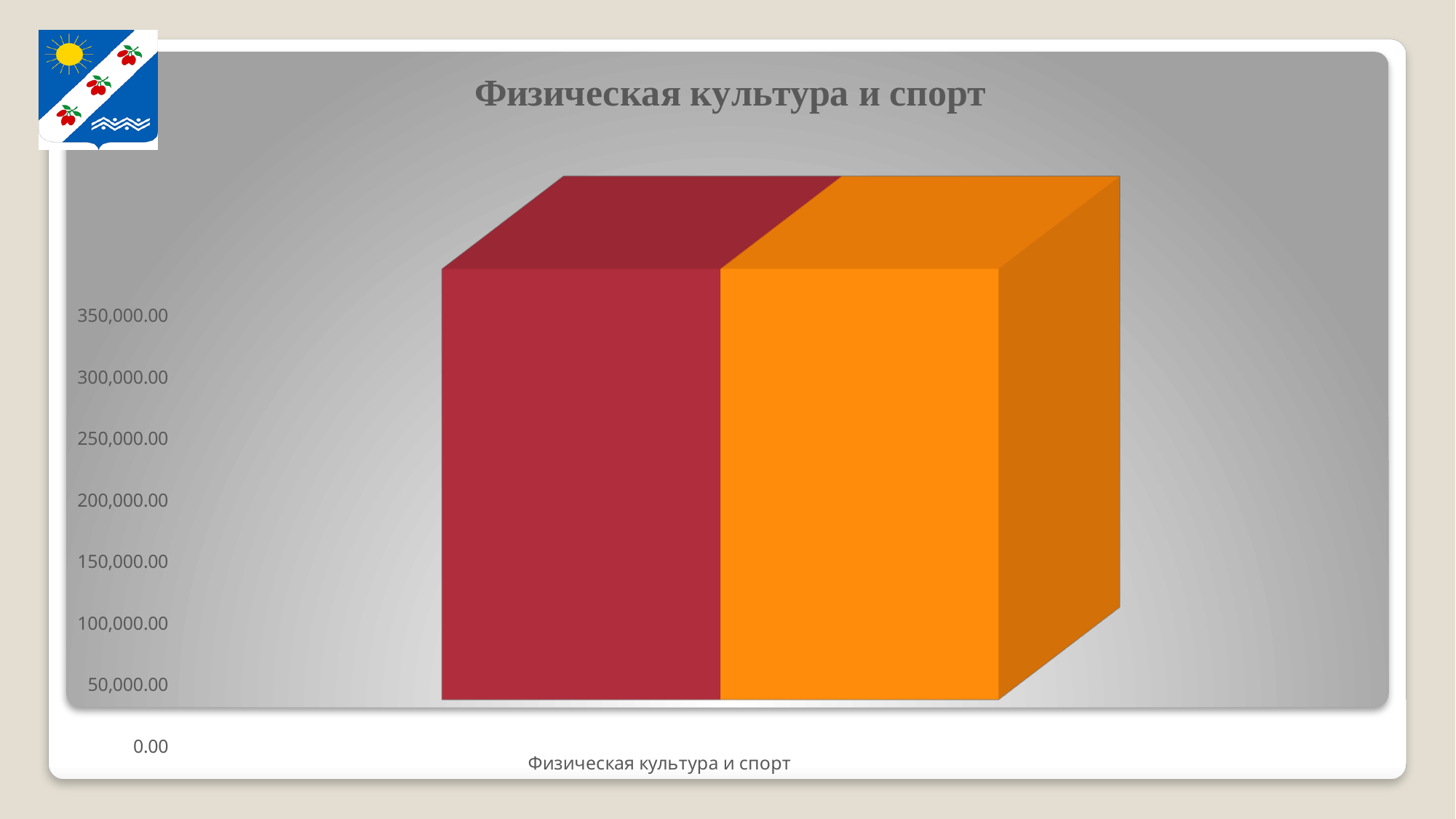
Is the value of the red bar greater or less than 200,000.00? greater What kind of chart is shown on the slide? bar chart What is the highest value labelled on the vertical axis of the chart? 350,000.00 What colours are the two bars in the chart? red and orange What is the category label on the x axis of the chart? Физическая культура и спорт How many categories are shown on the x axis of the chart? 1 Is the value of the orange bar greater or less than 300,000.00? greater How many bars are plotted in the chart? 2 What is the title of the chart? Физическая культура и спорт